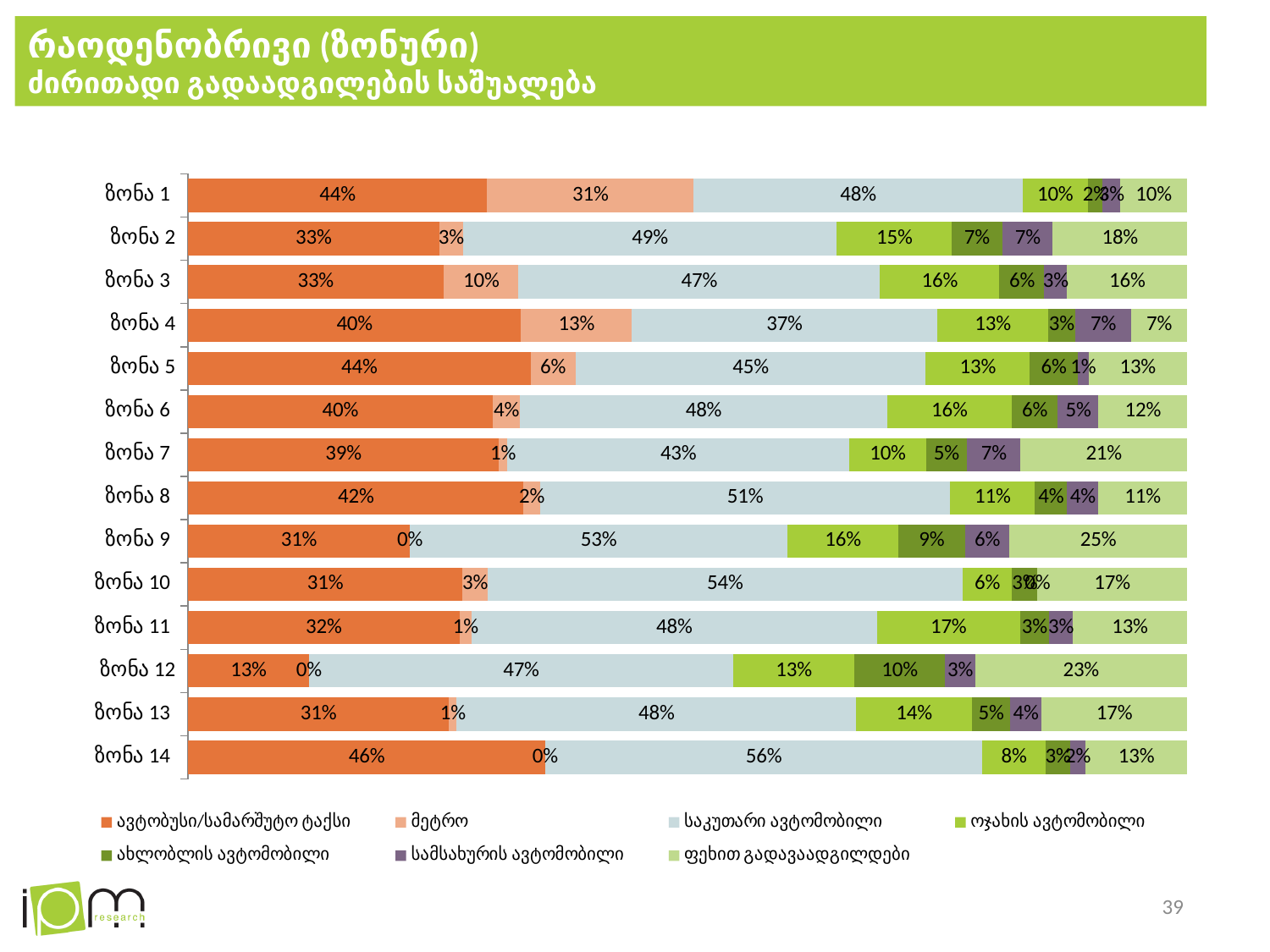
What type of chart is shown on the slide? Stacked bar chart What is the value for საკუთარი ავტომობილი in ზონა 14? 56% Which zone has the highest value for ავტობუსი/სამარშუტო ტაქსი? ზონა 14 How many zones (categories) are plotted on the chart? 14 What is the difference between the საკუთარი ავტომობილი values for ზონა 14 and ზონა 4? 19% What is the value for ავტობუსი/სამარშუტო ტაქსი in ზონა 12? 13% Which series is shown in orange in the legend? ავტობუსი/სამარშუტო ტაქსი What is the value for ფეხით გადავადგილდები in ზონა 9? 25% What is the value for მეტრო in ზონა 1? 31% How many series does the legend list? 7 Which zone has the lowest value for ავტობუსი/სამარშუტო ტაქსი? ზონა 12 Which is larger: the ფეხით გადავადგილდები value for ზონა 7 or for ზონა 8? ზონა 7